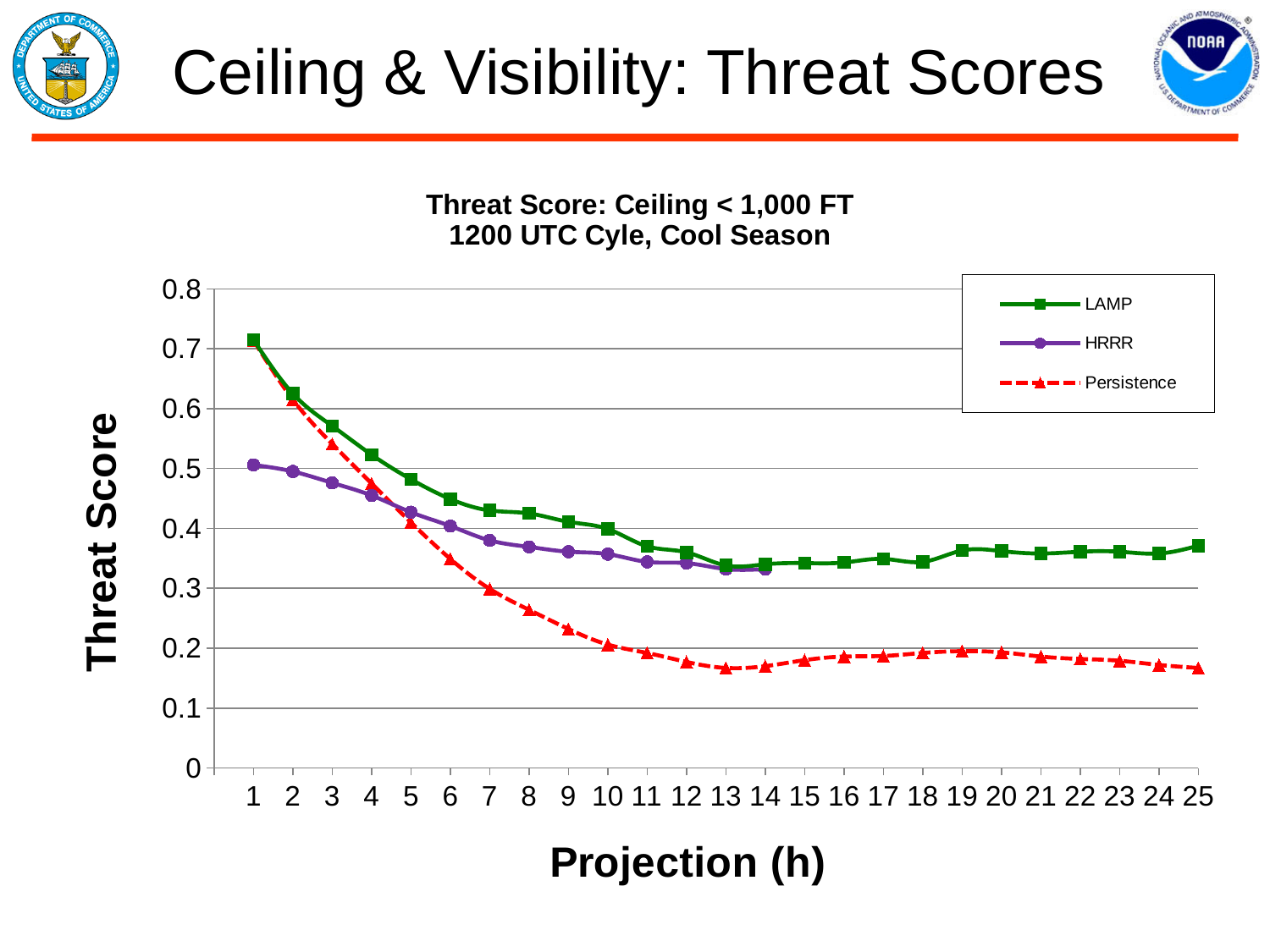
Which series has the highest threat score at projection 25? LAMP At projection 3, which series has the higher threat score, HRRR or Persistence? Persistence What kind of chart is shown on the slide? line chart Which series are listed in the legend? LAMP, HRRR, Persistence At projection 1, which series has the higher threat score, LAMP or HRRR? LAMP Is the Persistence threat score at projection 13 greater or less than 0.2? less How many projection hours are shown on the x axis? 25 Does the Persistence threat score rise or fall from projection 1 to projection 13? fall What is the label of the y axis? Threat Score Which series has the lowest threat score at projection 10? Persistence At projection 6, which series has the higher threat score, HRRR or Persistence? HRRR How many series does the legend list? 3